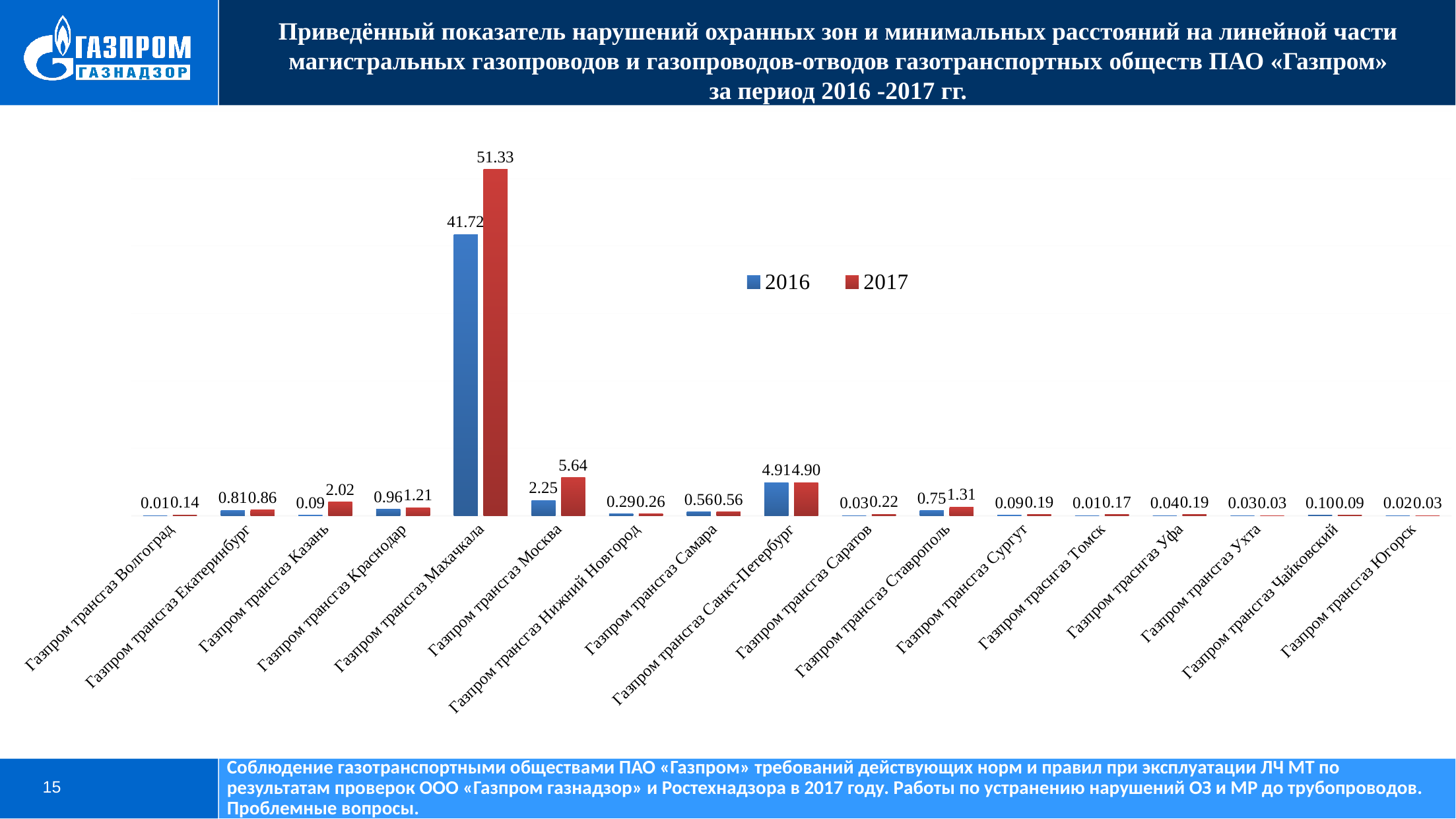
What is the 2016 value for Газпром трансгаз Москва? 2.25 How many series does the legend list? 2 What is the 2016 value for Газпром трансгаз Санкт-Петербург? 4.91 What is the difference between the 2017 and 2016 values for Газпром трансгаз Махачкала? 9.61 What is the 2017 value for Газпром трансгаз Казань? 2.02 Which is larger: the 2017 value for Газпром трансгаз Москва or the 2017 value for Газпром трансгаз Санкт-Петербург? Газпром трансгаз Москва What is the 2017 value for Газпром трансгаз Махачкала? 51.33 What is the difference between the 2017 and 2016 values for Газпром трансгаз Москва? 3.39 Which is larger for Газпром трансгаз Ставрополь: the 2016 value or the 2017 value? 2017 Which company has the highest 2017 value? Газпром трансгаз Махачкала How many companies are shown on the x axis of the chart? 17 What type of chart is shown on the slide? Bar chart